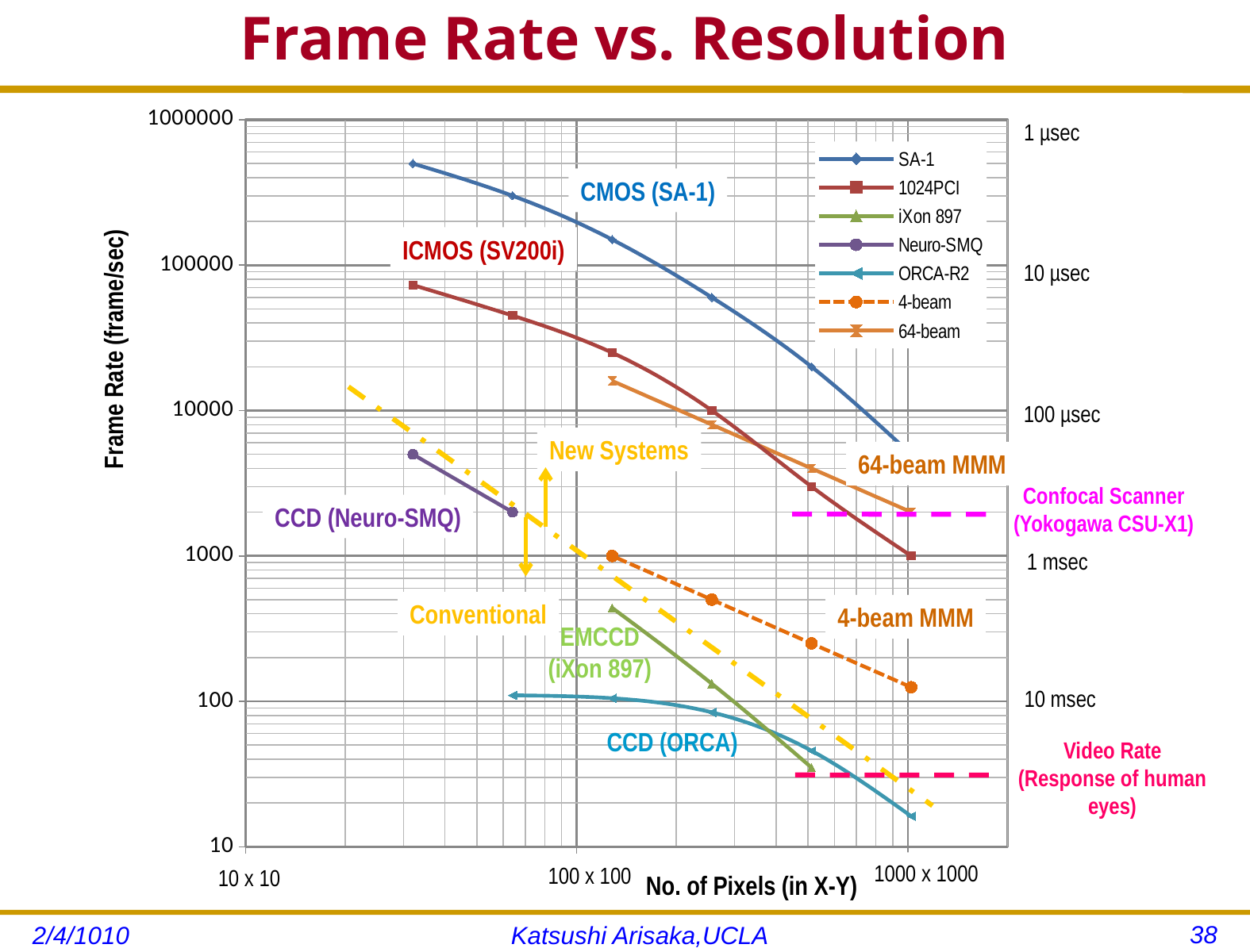
Which series has the highest frame rate across the chart? SA-1 What kind of chart is shown on the slide? line chart At 100 x 100 pixels, which has the higher frame rate, SA-1 or 1024PCI? SA-1 Is the frame rate for ORCA-R2 at 100 x 100 pixels greater or less than 1000? less Is the frame rate for iXon 897 at 100 x 100 pixels greater or less than 1000? less Which series in the legend is drawn with a dashed line? 4-beam Is the frame rate for SA-1 at 100 x 100 pixels greater or less than 100000? greater At 1000 x 1000 pixels, which has the higher frame rate, 64-beam or 1024PCI? 64-beam How many series does the legend list? 7 Does the frame rate rise or fall as the number of pixels increases along the x axis? fall What is the title of the y axis? Frame Rate (frame/sec) Which series has the lowest frame rate at 1000 x 1000 pixels? ORCA-R2